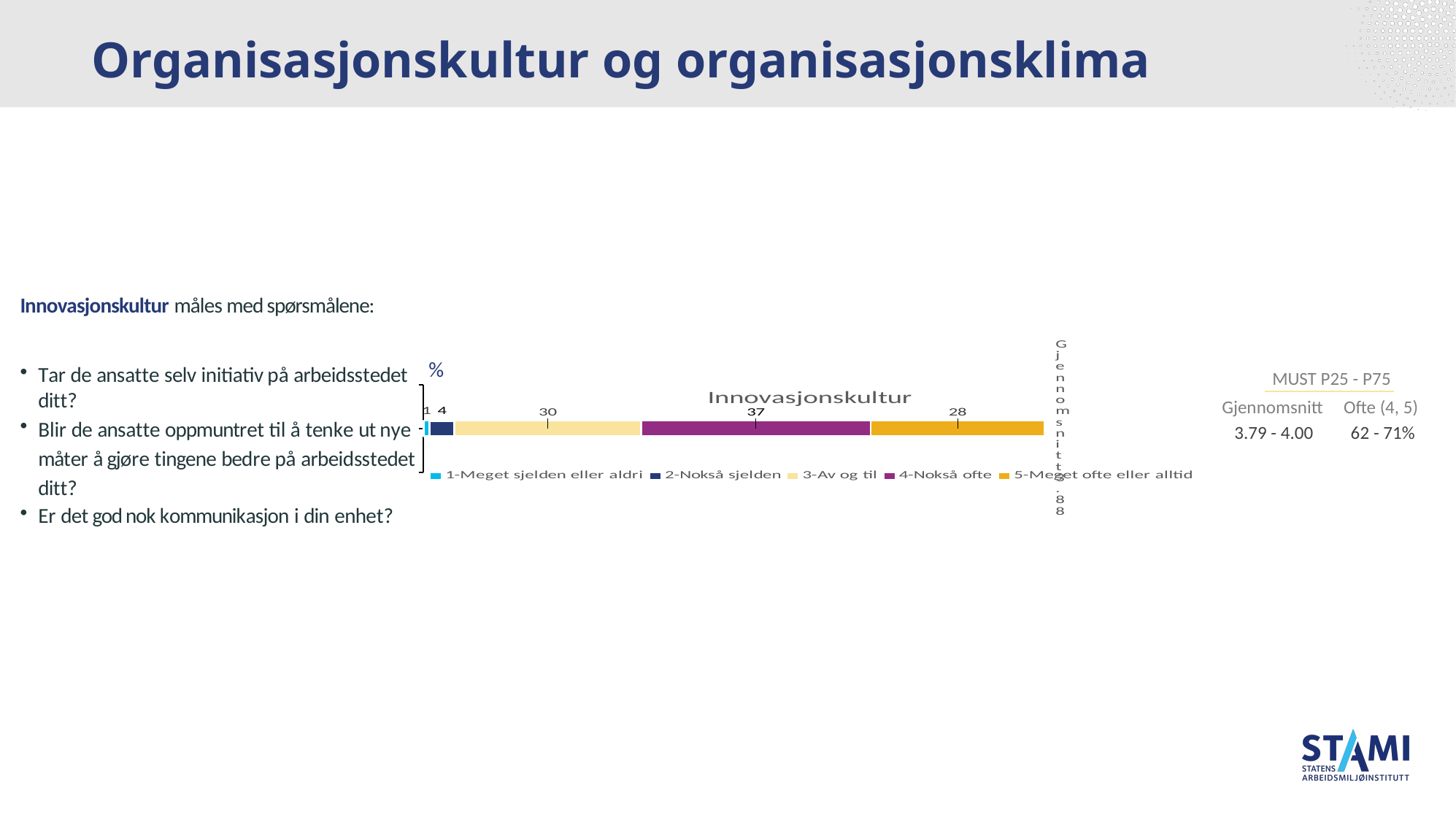
What is the value for the series '5-Meget ofte eller alltid' in the Innovasjonskultur bar? 28 What is the value for the series '2-Nokså sjelden' in the Innovasjonskultur bar? 4 What is the value for the series '4-Nokså ofte' in the Innovasjonskultur bar? 37 What type of chart is shown on the slide? bar chart What is the title of the chart? Innovasjonskultur Which series has the smallest value in the Innovasjonskultur bar? 1-Meget sjelden eller aldri What is the difference between the values for '4-Nokså ofte' and '5-Meget ofte eller alltid'? 9 What is the value for the series '3-Av og til' in the Innovasjonskultur bar? 30 What is the value for the series '1-Meget sjelden eller aldri' in the Innovasjonskultur bar? 1 How many series does the chart legend list? 5 What is the total of all segments in the Innovasjonskultur stacked bar? 100 Which series has the largest value in the Innovasjonskultur bar? 4-Nokså ofte